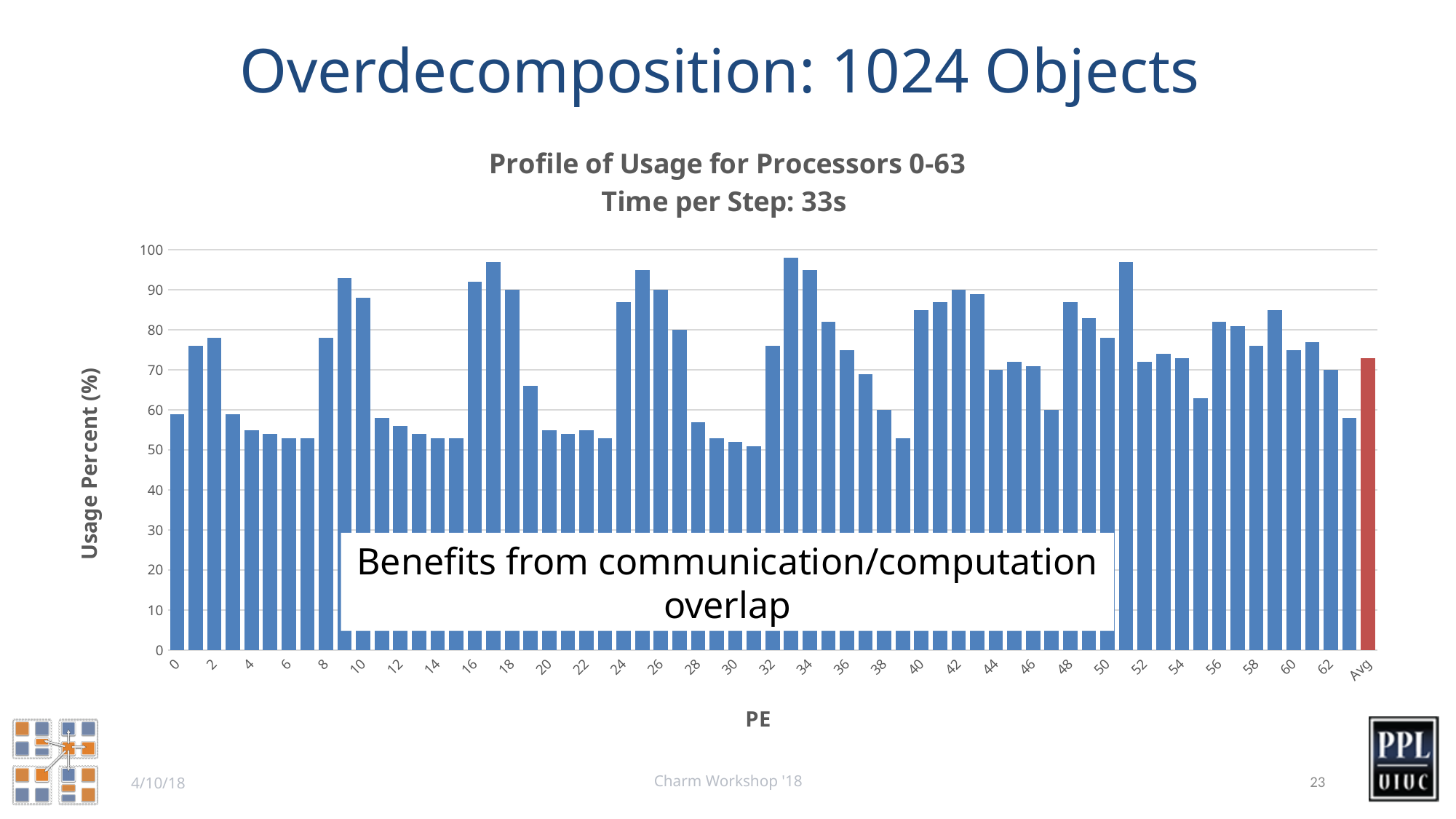
Is the value for PE 33 greater or less than 90? greater Is the value for PE 19 greater or less than 70? less Is the value for Avg greater or less than 70? greater Which has the higher usage percent, PE 0 or Avg? Avg Which has the higher usage percent, PE 17 or PE 19? PE 17 What is the label of the y axis? Usage Percent (%) What kind of chart is shown on the slide? bar chart How many bars are plotted in the chart, including the Avg bar? 65 What is the title of the chart? Profile of Usage for Processors 0-63 Time per Step: 33s Which has the higher usage percent, PE 31 or PE 33? PE 33